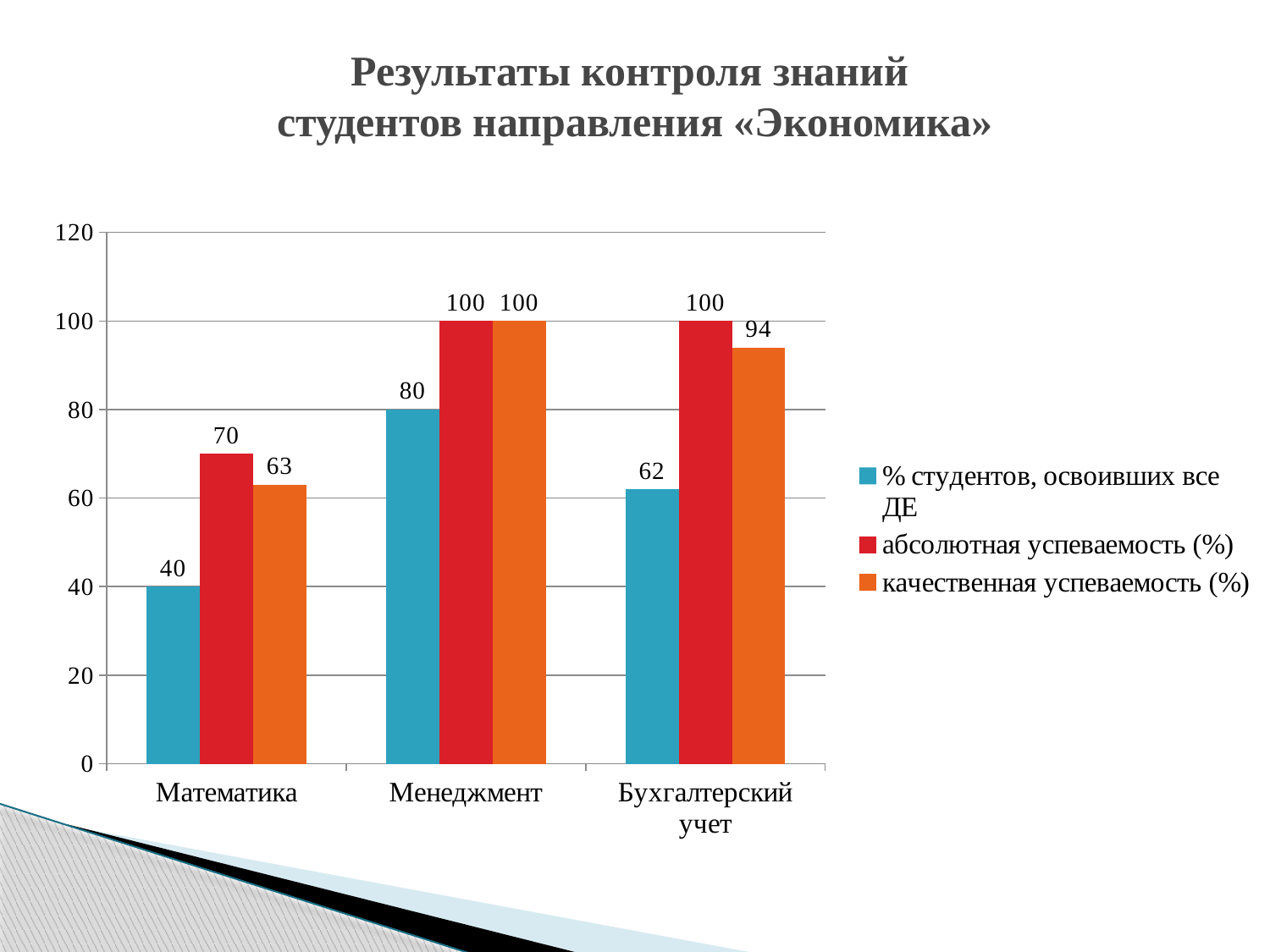
What is the value of 'абсолютная успеваемость (%)' for Бухгалтерский учет? 100 What is the value of 'качественная успеваемость (%)' for Бухгалтерский учет? 94 How many categories are shown on the x axis? 3 Which category has the lowest value for '% студентов, освоивших все ДЕ'? Математика What is the value of '% студентов, освоивших все ДЕ' for Математика? 40 What is the difference between 'абсолютная успеваемость (%)' and 'качественная успеваемость (%)' for Математика? 7 Which category has the highest value for '% студентов, освоивших все ДЕ'? Менеджмент How many series does the legend list? 3 What colour represents 'абсолютная успеваемость (%)' in the chart? Red What kind of chart is shown on the slide? Bar chart Which is larger for Бухгалтерский учет: 'абсолютная успеваемость (%)' or 'качественная успеваемость (%)'? абсолютная успеваемость (%) What is the value of 'качественная успеваемость (%)' for Математика? 63